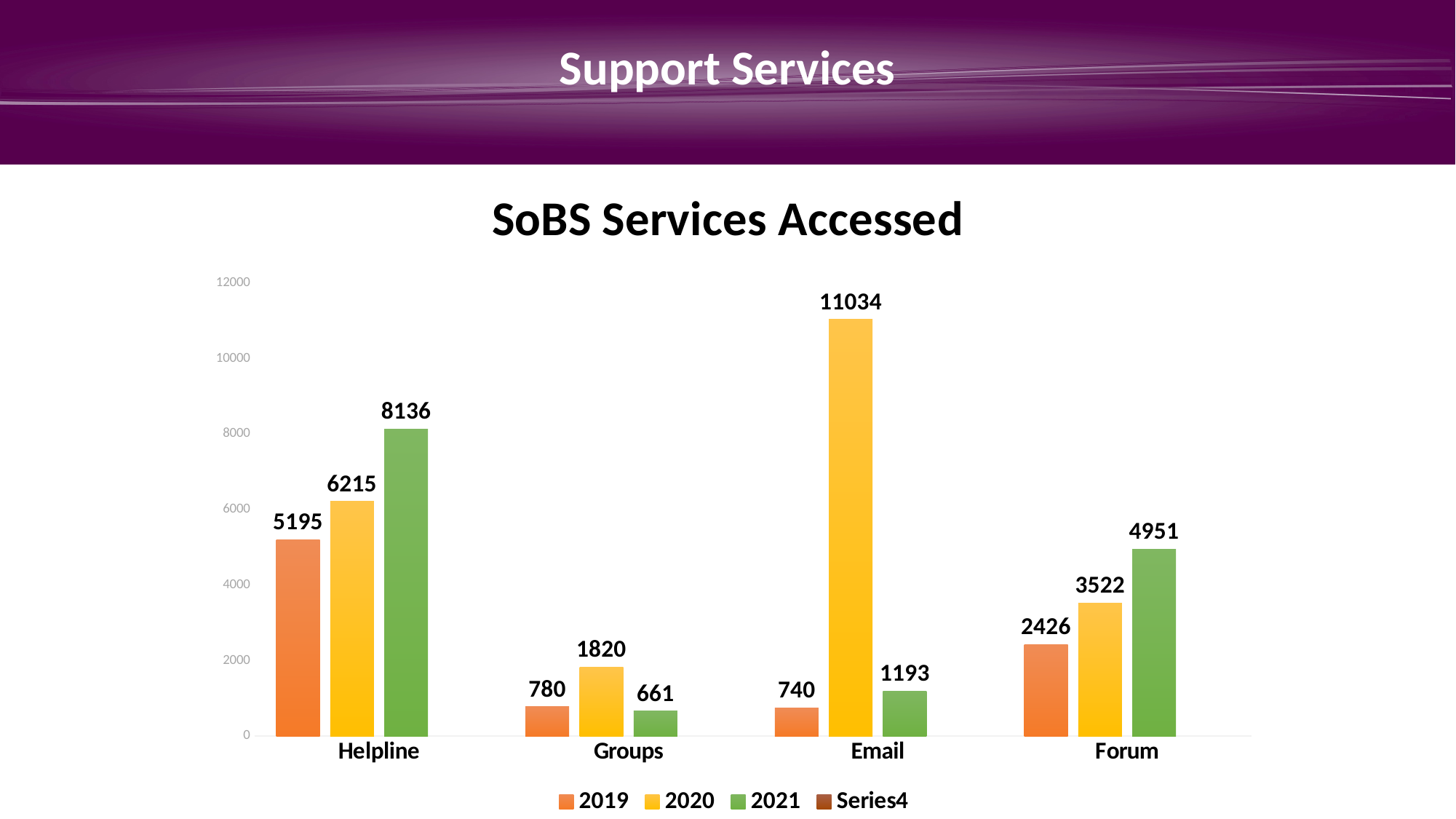
How many categories are shown on the x axis? 4 What is the value for Groups in 2021? 661 What is the value for Email in 2020? 11034 What is the difference between the 2021 and 2019 values for Helpline? 2941 What kind of chart is shown on the slide? Bar chart What is the value for Helpline in 2021? 8136 Which is larger, the 2020 value for Groups or the 2021 value for Email? 2020 value for Groups What is the title of the chart? SoBS Services Accessed How many series does the legend list? 4 Which category has the lowest value in 2019? Email What is the value for Forum in 2019? 2426 Which category has the highest value in 2020? Email